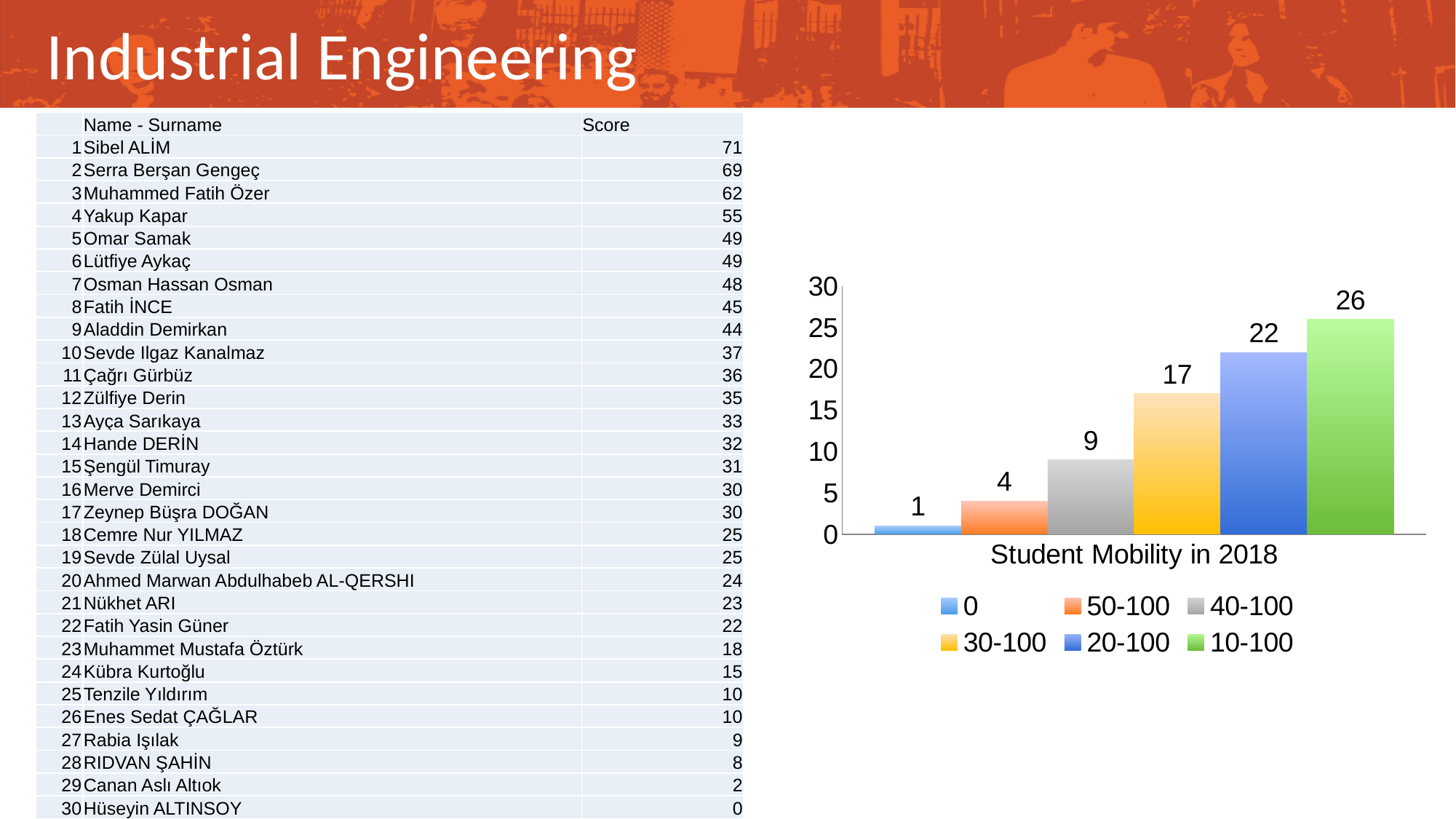
Do the values in the Student Mobility in 2018 chart rise or fall from left to right? rise What is the difference between the 20-100 and 40-100 values in the Student Mobility in 2018 chart? 13 What is the value for the 10-100 series in the Student Mobility in 2018 chart? 26 What colour is the bar for the 30-100 series in the Student Mobility in 2018 chart? yellow How many series does the legend of the Student Mobility in 2018 chart list? 6 What is the value for the 30-100 series in the Student Mobility in 2018 chart? 17 Which series has the highest value in the Student Mobility in 2018 chart? 10-100 Is the value for 20-100 in the Student Mobility in 2018 chart greater or less than 20? greater Which is larger in the Student Mobility in 2018 chart, the 40-100 value or the 50-100 value? 40-100 What kind of chart is the Student Mobility in 2018 chart? bar chart What is the value for the 50-100 series in the Student Mobility in 2018 chart? 4 Which series has the lowest value in the Student Mobility in 2018 chart? 0